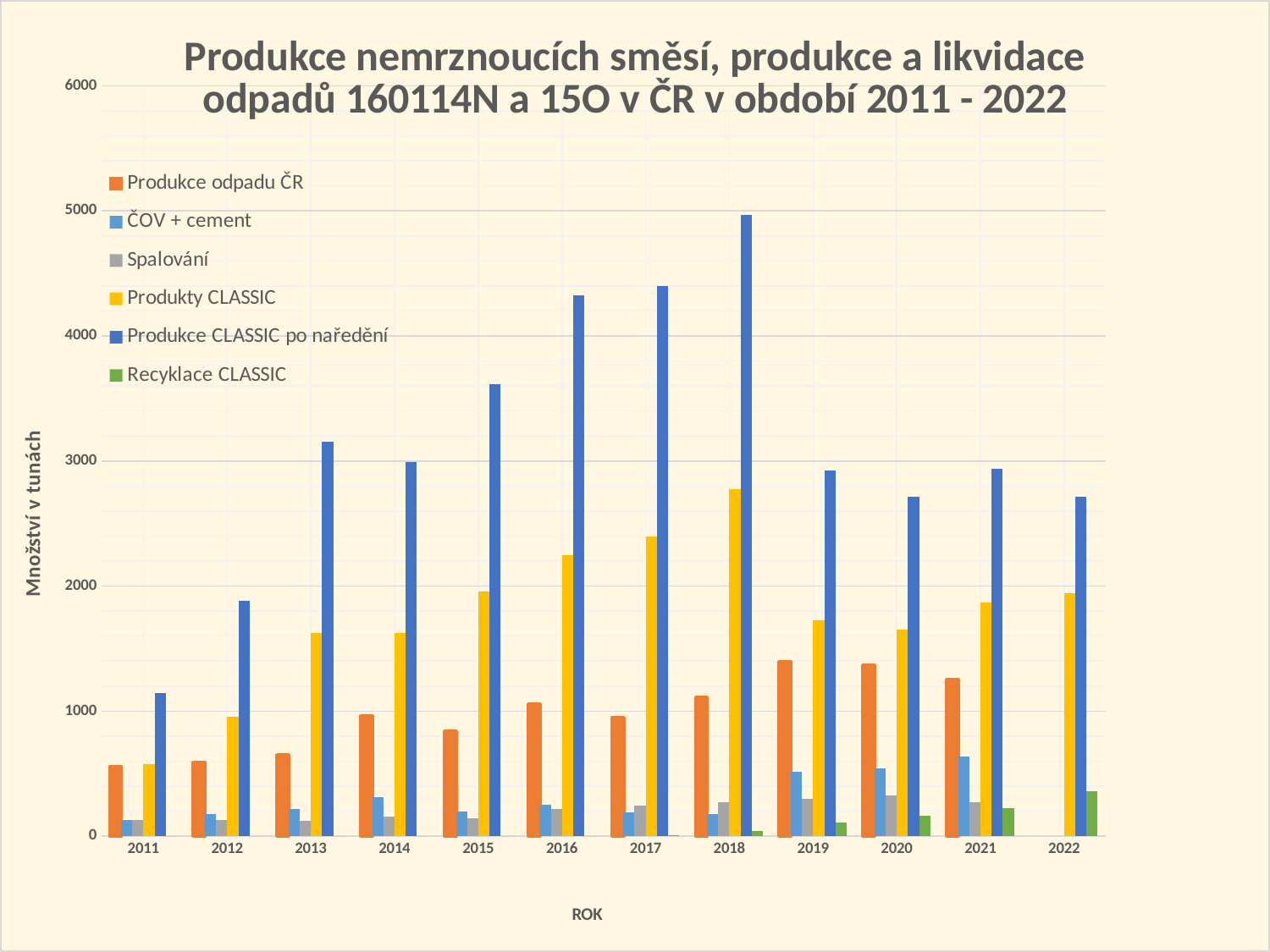
How many series does the legend list? 6 What is the title of the vertical axis? Množství v tunách Is the value for Produkce CLASSIC po naředění in 2018 greater or less than 4000? greater Which is larger: Produkce CLASSIC po naředění in 2016 or in 2019? 2016 Is the value for Produkty CLASSIC in 2016 greater or less than 2000? greater In which year is the value for Recyklace CLASSIC highest? 2022 Do the values for Recyklace CLASSIC rise or fall from 2018 to 2022? rise In which year is the value for Produkce CLASSIC po naředění highest? 2018 Is the value for Produkce odpadu ČR in 2011 greater or less than 1000? less What kind of chart is shown on the slide? bar chart In which year is the value for Produkce CLASSIC po naředění lowest? 2011 How many years are shown on the x axis? 12